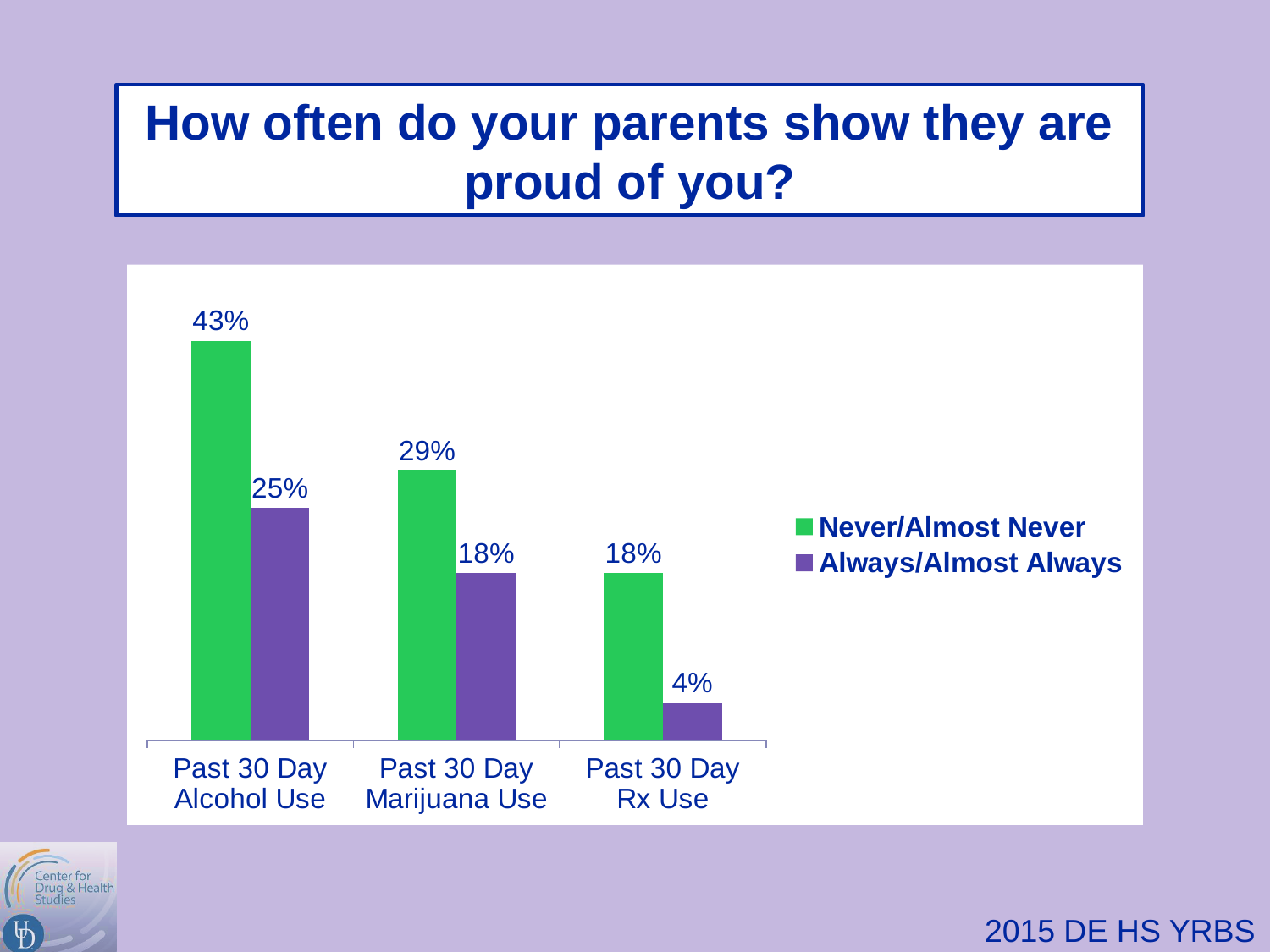
Which is larger for Past 30 Day Marijuana Use: Never/Almost Never or Always/Almost Always? Never/Almost Never Do the Never/Almost Never values rise or fall from left to right across the categories? Fall What is the difference between the Never/Almost Never and Always/Almost Always values for Past 30 Day Alcohol Use? 18% Which category has the lowest Always/Almost Always value? Past 30 Day Rx Use What is the value for Always/Almost Always for Past 30 Day Marijuana Use? 18% Which category has the highest Never/Almost Never value? Past 30 Day Alcohol Use What kind of chart is shown on the slide? Bar chart What is the difference between the Never/Almost Never values for Past 30 Day Marijuana Use and Past 30 Day Rx Use? 11% How many categories are shown on the x axis? 3 How many series does the legend list? 2 What is the value for Always/Almost Always for Past 30 Day Rx Use? 4% What is the value for Never/Almost Never for Past 30 Day Alcohol Use? 43%